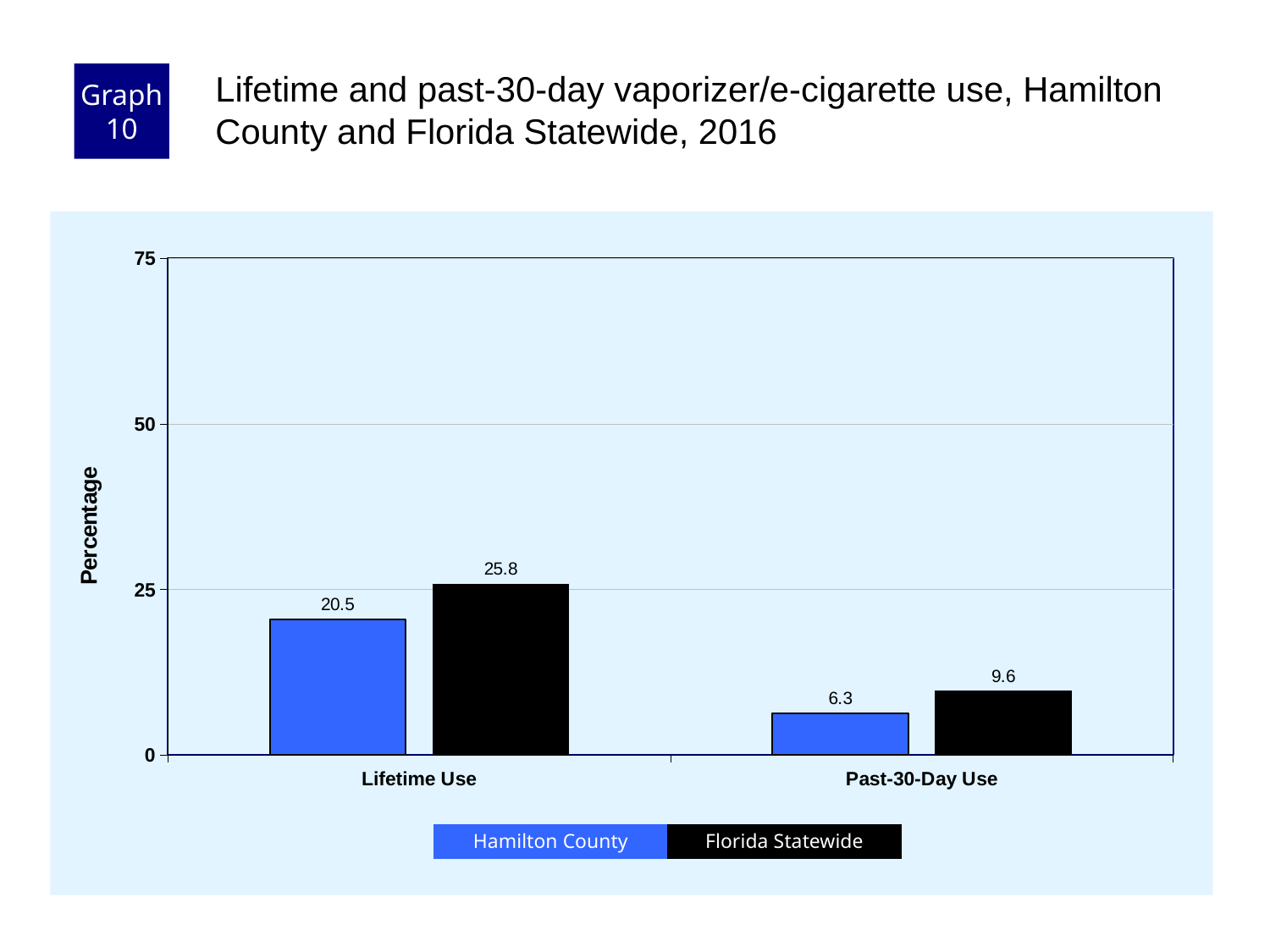
What is the difference between the Florida Statewide and Hamilton County values for Lifetime Use? 5.3 What is the Hamilton County value for Lifetime Use? 20.5 How many series does the legend list? 2 For Past-30-Day Use, which is larger: Hamilton County or Florida Statewide? Florida Statewide What type of chart is shown on the slide? Bar chart What is the Florida Statewide value for Lifetime Use? 25.8 What is the Hamilton County value for Past-30-Day Use? 6.3 Which bar has the lowest value on the chart? Hamilton County, Past-30-Day Use Which bar has the highest value on the chart? Florida Statewide, Lifetime Use How many categories are shown on the x axis? 2 What is the difference between the Florida Statewide and Hamilton County values for Past-30-Day Use? 3.3 What is the Florida Statewide value for Past-30-Day Use? 9.6